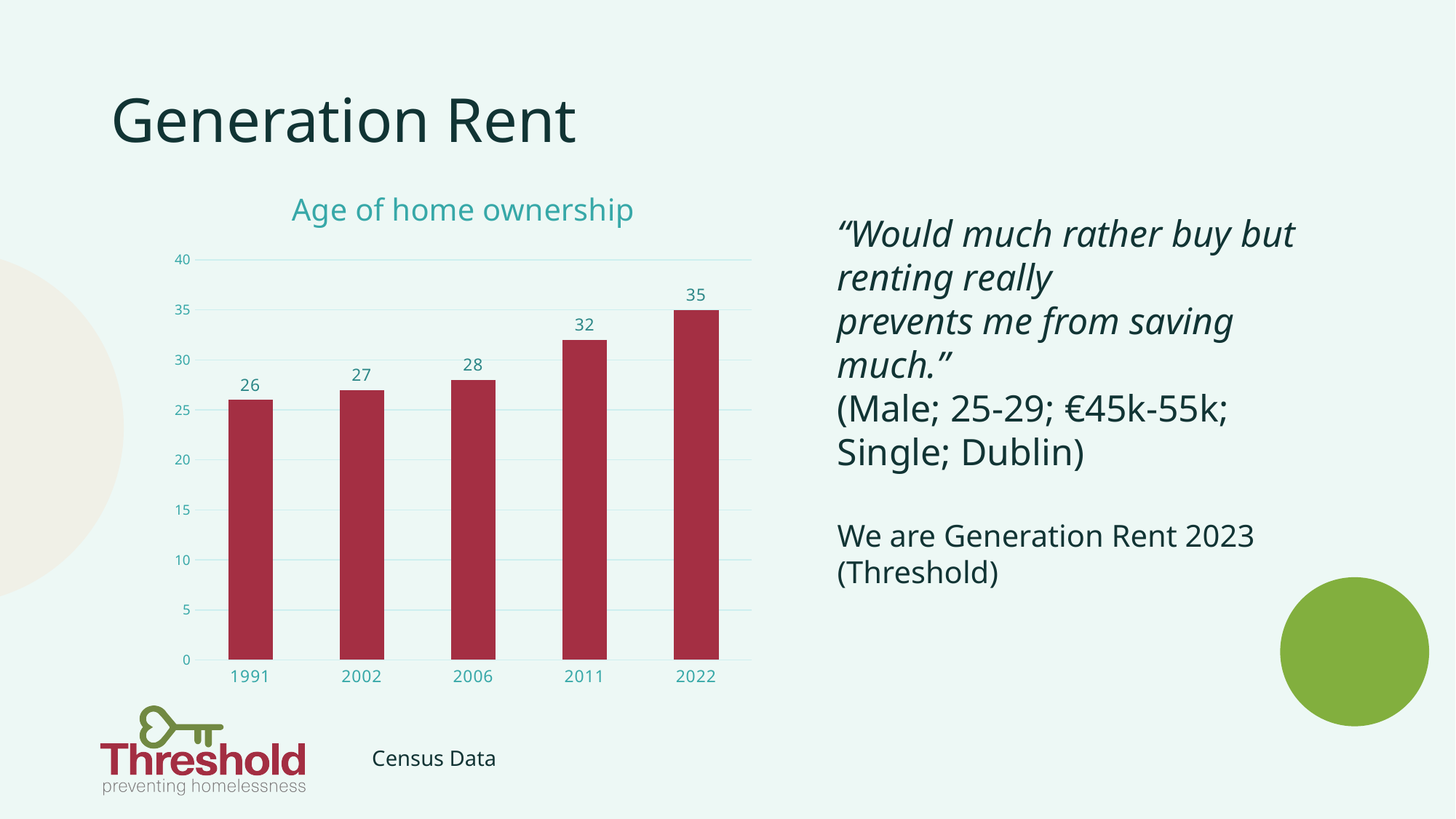
By how much did the age of home ownership increase from 1991 to 2022? 9 How many years are shown on the x axis of the chart? 5 What is the age of home ownership shown for 2022? 35 What is the difference between the values for 2006 and 2011? 4 Which year has the lowest age of home ownership? 1991 Which year has the highest age of home ownership? 2022 What value is shown for 2011 in the Age of home ownership chart? 32 What is the age of home ownership shown for 1991? 26 Which is larger, the value for 2002 or the value for 2011? 2011 Is the value for 2006 greater or less than 30? less What kind of chart is used to show the age of home ownership? bar chart Does the age of home ownership rise or fall from 1991 to 2022? rise